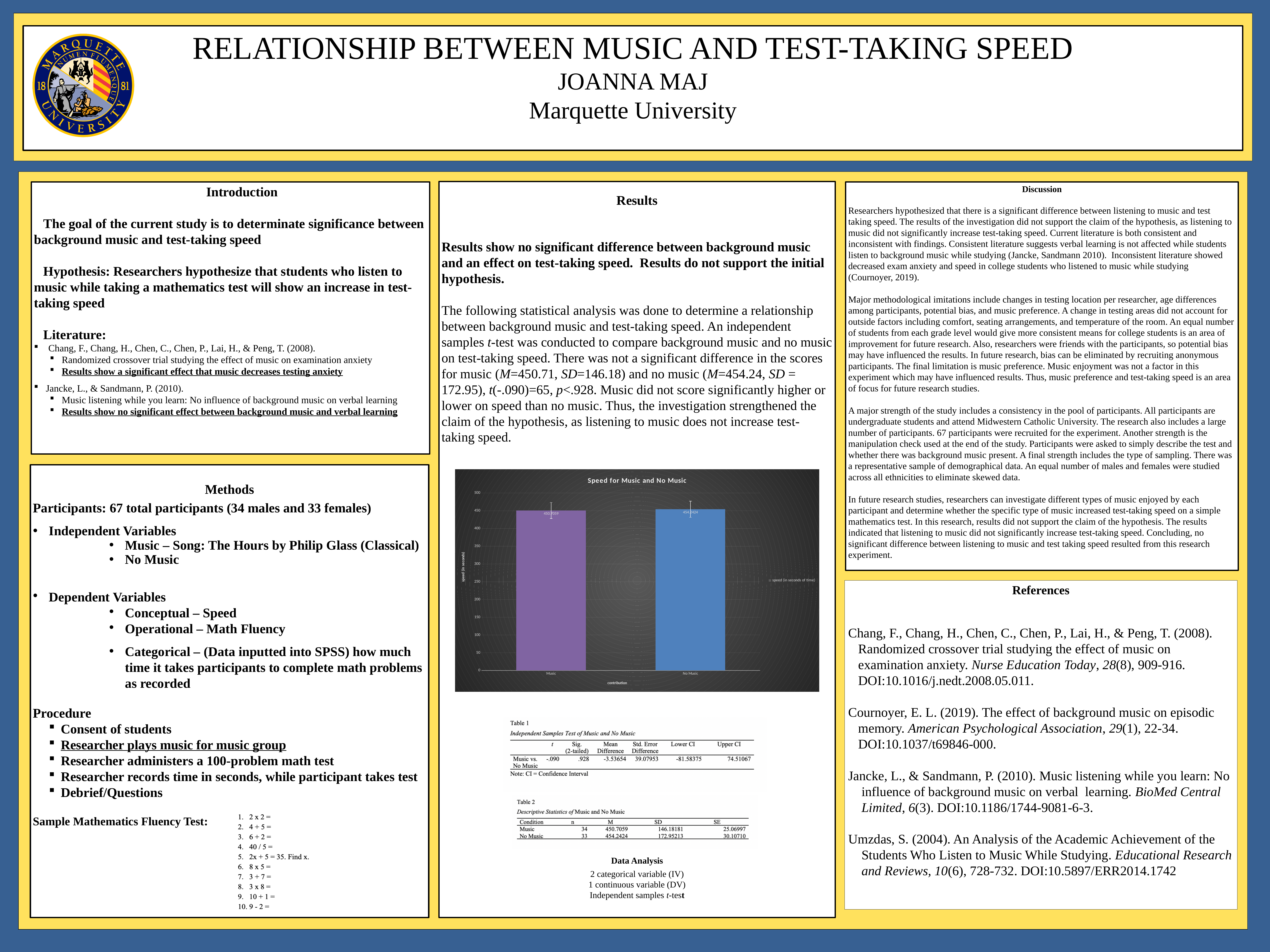
What is the difference between the No Music value and the Music value in the chart? 3.5365 Is the value for No Music greater or less than 500? less Is the value for Music greater or less than 400? greater How many categories are plotted on the x axis of the chart? 2 What is the title of the chart? Speed for Music and No Music What is the legend entry shown in the chart? speed (in seconds of time) How many series does the chart's legend list? 1 What is the value shown for Music in the chart? 450.7059 What is the value shown for No Music in the chart? 454.2424 What kind of chart is shown on the slide? bar chart Is the value for Music greater or less than 350? greater